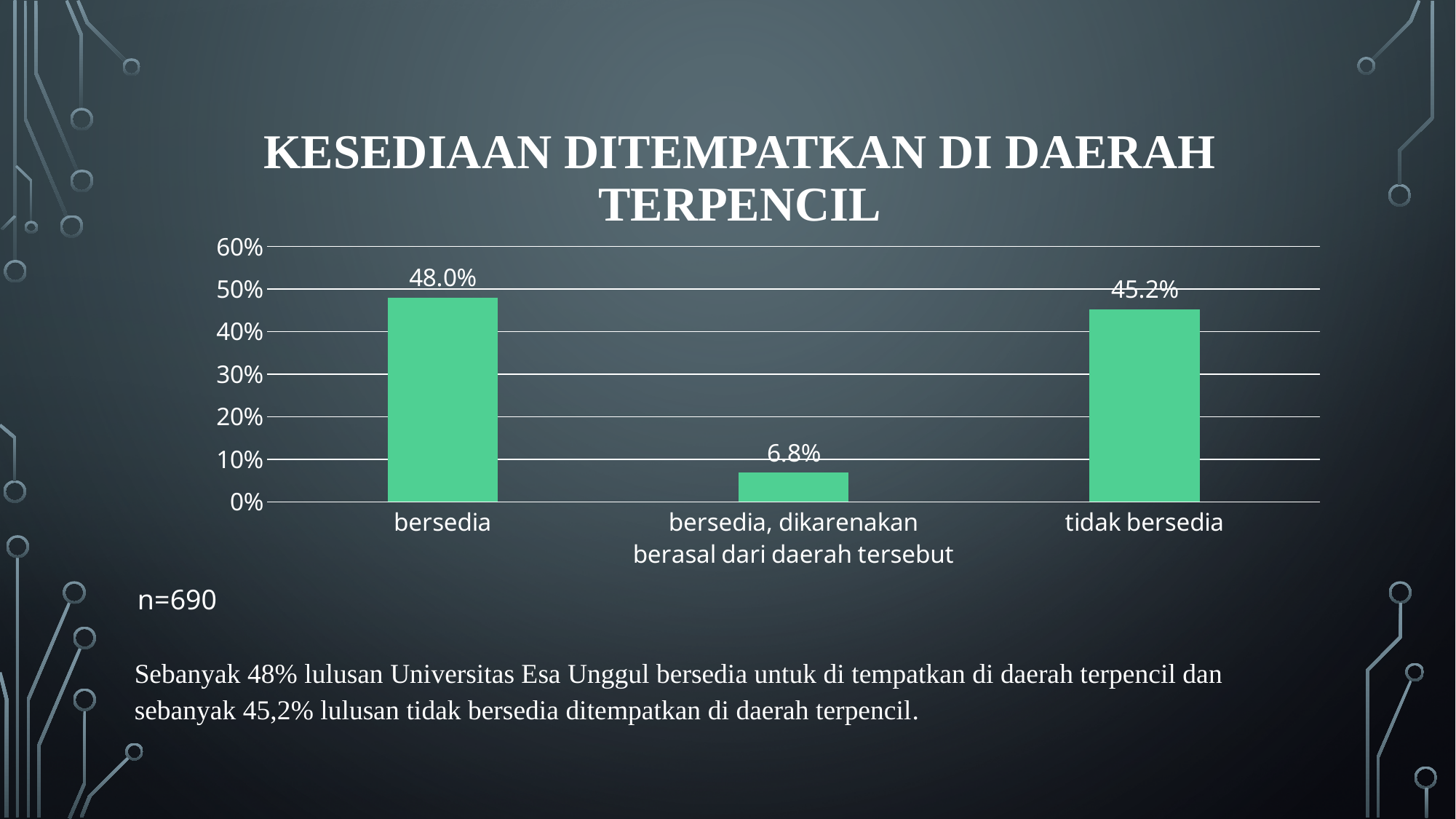
What is the value for "tidak bersedia"? 45.2% How many categories are shown on the x axis? 3 What is the value for "bersedia"? 48.0% What is the difference between the values for "bersedia" and "tidak bersedia"? 2.8% What kind of chart is shown on the slide? bar chart Is the value for "tidak bersedia" greater or less than 40%? greater Which category has the lowest value? bersedia, dikarenakan berasal dari daerah tersebut What is the title of the chart? KESEDIAAN DITEMPATKAN DI DAERAH TERPENCIL What is the difference between the values for "tidak bersedia" and "bersedia, dikarenakan berasal dari daerah tersebut"? 38.4% What is the value for "bersedia, dikarenakan berasal dari daerah tersebut"? 6.8% Which is larger, the value for "bersedia" or the value for "bersedia, dikarenakan berasal dari daerah tersebut"? bersedia Which category has the highest value? bersedia